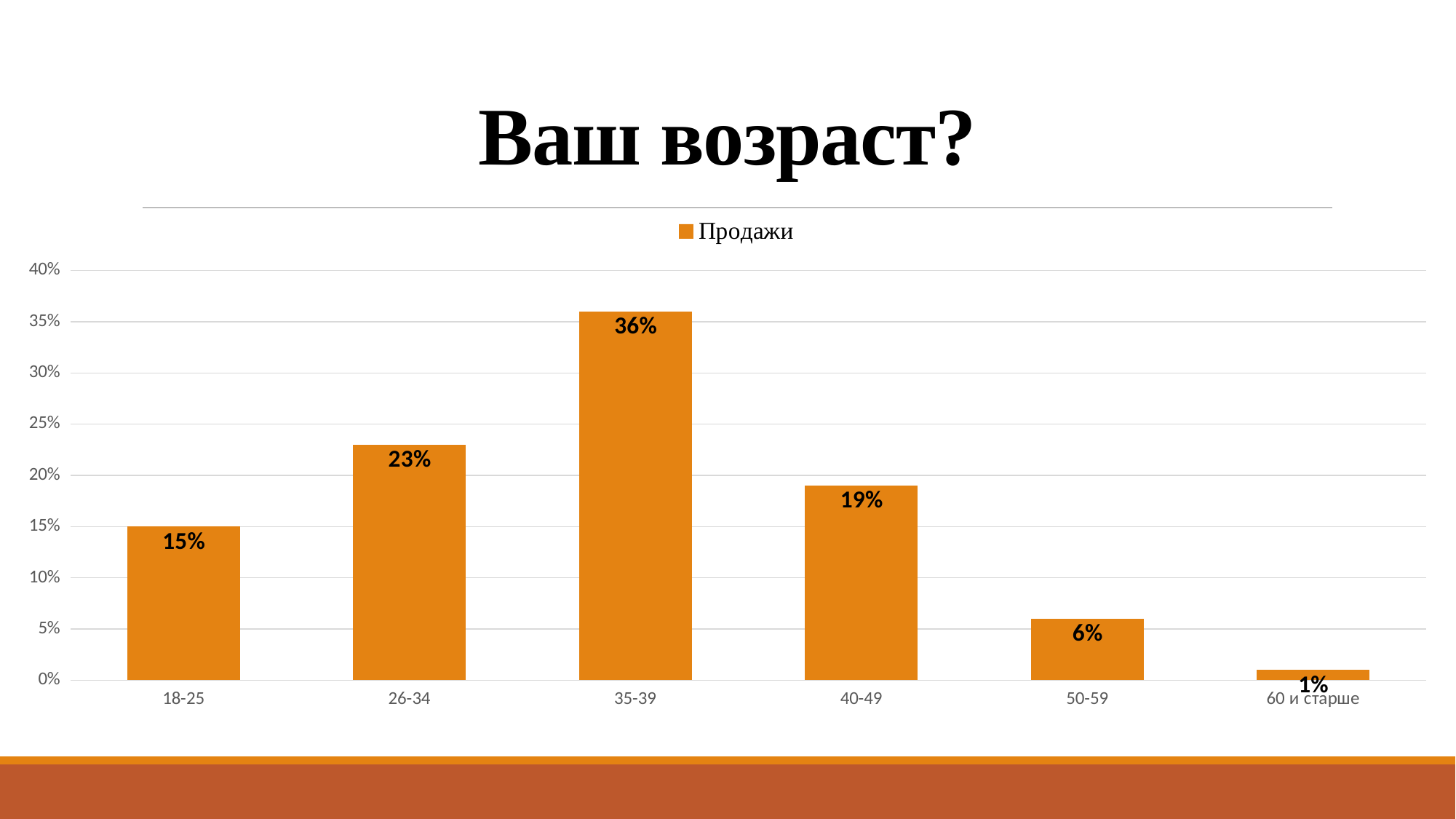
What kind of chart is shown on the slide? bar chart What is the value for the 50-59 age group? 6% How many age groups are shown on the x axis? 6 What is the difference between the values for 40-49 and 50-59? 13% Which is larger, the value for 26-34 or the value for 40-49? 26-34 Which age group has the lowest value? 60 и старше What is the title of the slide? Ваш возраст? Is the value for 40-49 greater or less than 20%? less What is the difference between the values for 35-39 and 26-34? 13% What is the value for the 18-25 age group? 15% What is the value for the 35-39 age group? 36% Which age group has the highest value? 35-39